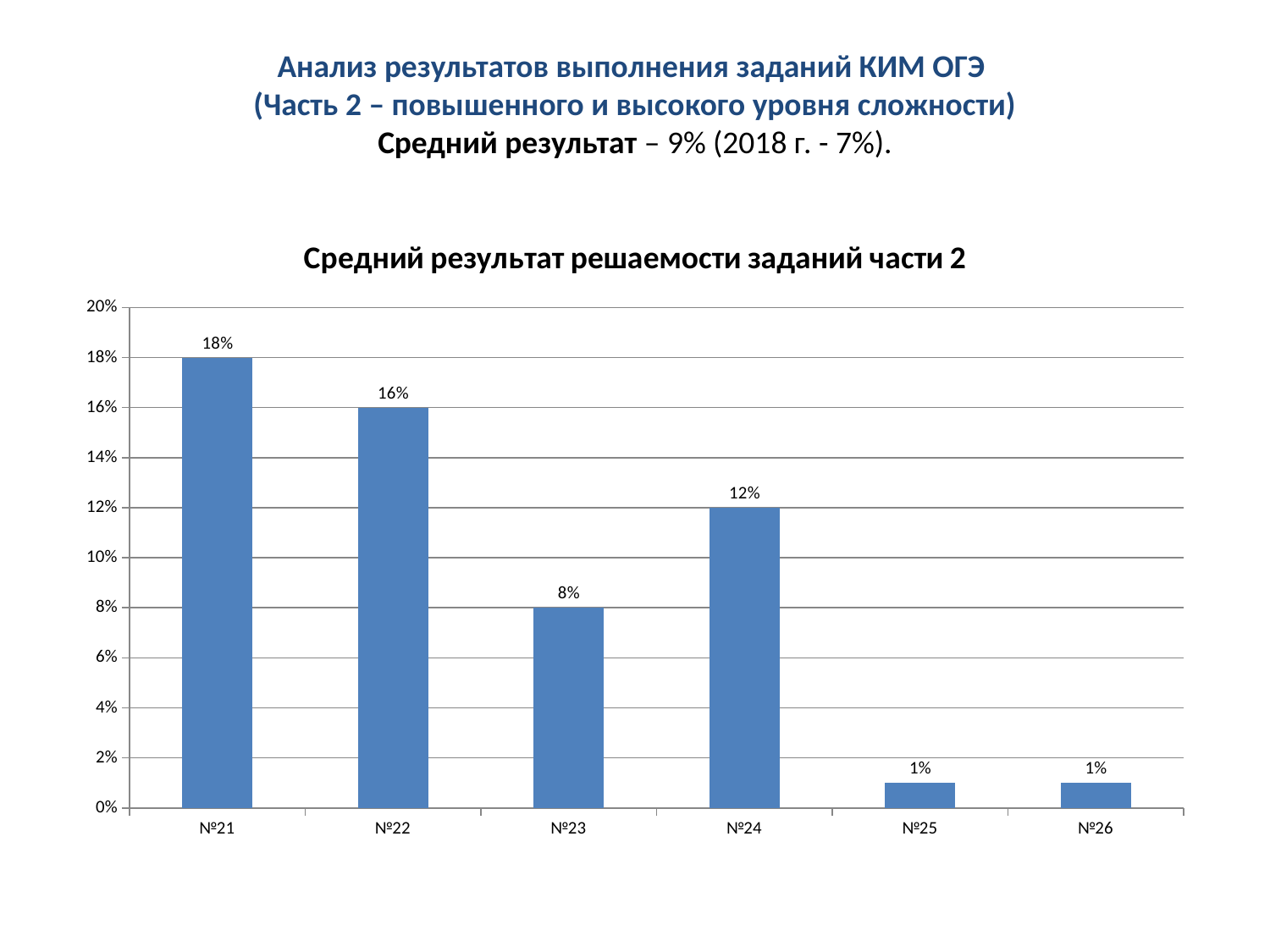
What is the value for №24? 12% Which category has the highest value? №21 What is the value for №21? 18% Is the value for №23 greater or less than 10%? less How many categories are shown on the x axis? 6 What is the value for №23? 8% What kind of chart is shown on the slide? bar chart What is the title of the chart? Средний результат решаемости заданий части 2 What is the difference between the values for №21 and №22? 2% What is the value for №26? 1% What is the difference between the values for №24 and №23? 4% Which is larger, the value for №22 or the value for №24? №22